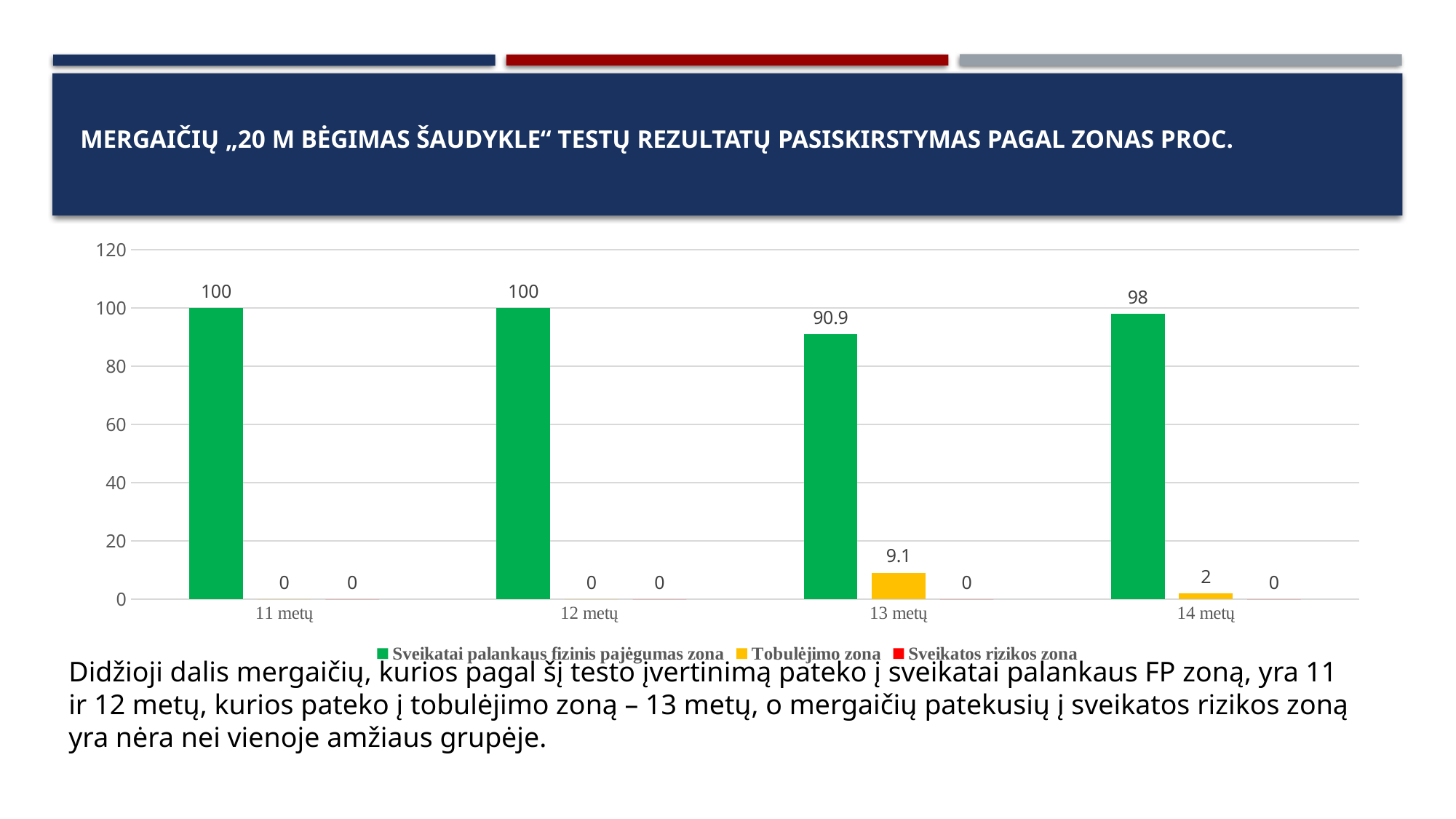
How many age groups are shown on the x axis? 4 What is the value for "Tobulėjimo zona" for 14 metų? 2 What is the difference between the "Sveikatai palankaus fizinis pajėgumas zona" values for 12 metų and 14 metų? 2 What is the value for "Sveikatai palankaus fizinis pajėgumas zona" for 14 metų? 98 Which is larger: the "Tobulėjimo zona" value for 13 metų or for 14 metų? 13 metų What kind of chart is shown on the slide? bar chart How many series does the legend list? 3 What is the value for "Sveikatai palankaus fizinis pajėgumas zona" for 13 metų? 90.9 What is the value for "Tobulėjimo zona" for 13 metų? 9.1 Which age group has the highest value for "Tobulėjimo zona"? 13 metų What is the value for "Sveikatos rizikos zona" for 11 metų? 0 Which age group has the lowest value for "Sveikatai palankaus fizinis pajėgumas zona"? 13 metų